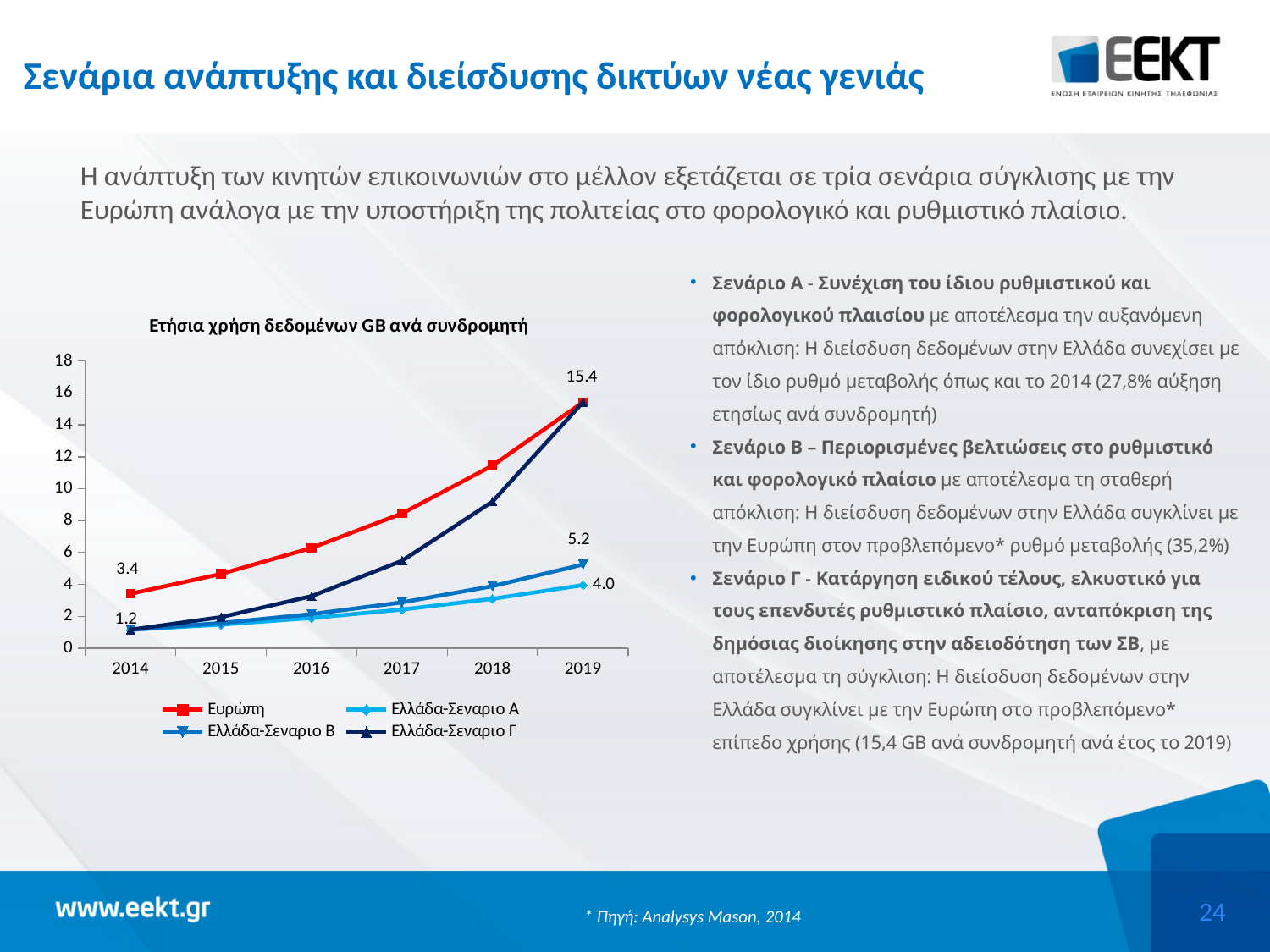
How many series does the chart legend list? 4 What is the value for Ελλάδα-Σενάριο Β in 2019? 5.2 What is the value for Ευρώπη in 2014? 3.4 Is the value for Ευρώπη in 2018 greater or less than 10? greater How many years are shown on the x axis of the chart? 6 Does the value for Ευρώπη rise or fall from 2014 to 2019? rise What kind of chart is shown on the slide? line chart By how much does the value for Ευρώπη increase from 2014 to 2019? 12.0 What is the difference between Ελλάδα-Σενάριο Β and Ελλάδα-Σενάριο Α in 2019? 1.2 Which series has the lowest value in 2019? Ελλάδα-Σενάριο Α What is the value for Ελλάδα-Σενάριο Α in 2019? 4.0 What is the value for Ευρώπη in 2019? 15.4